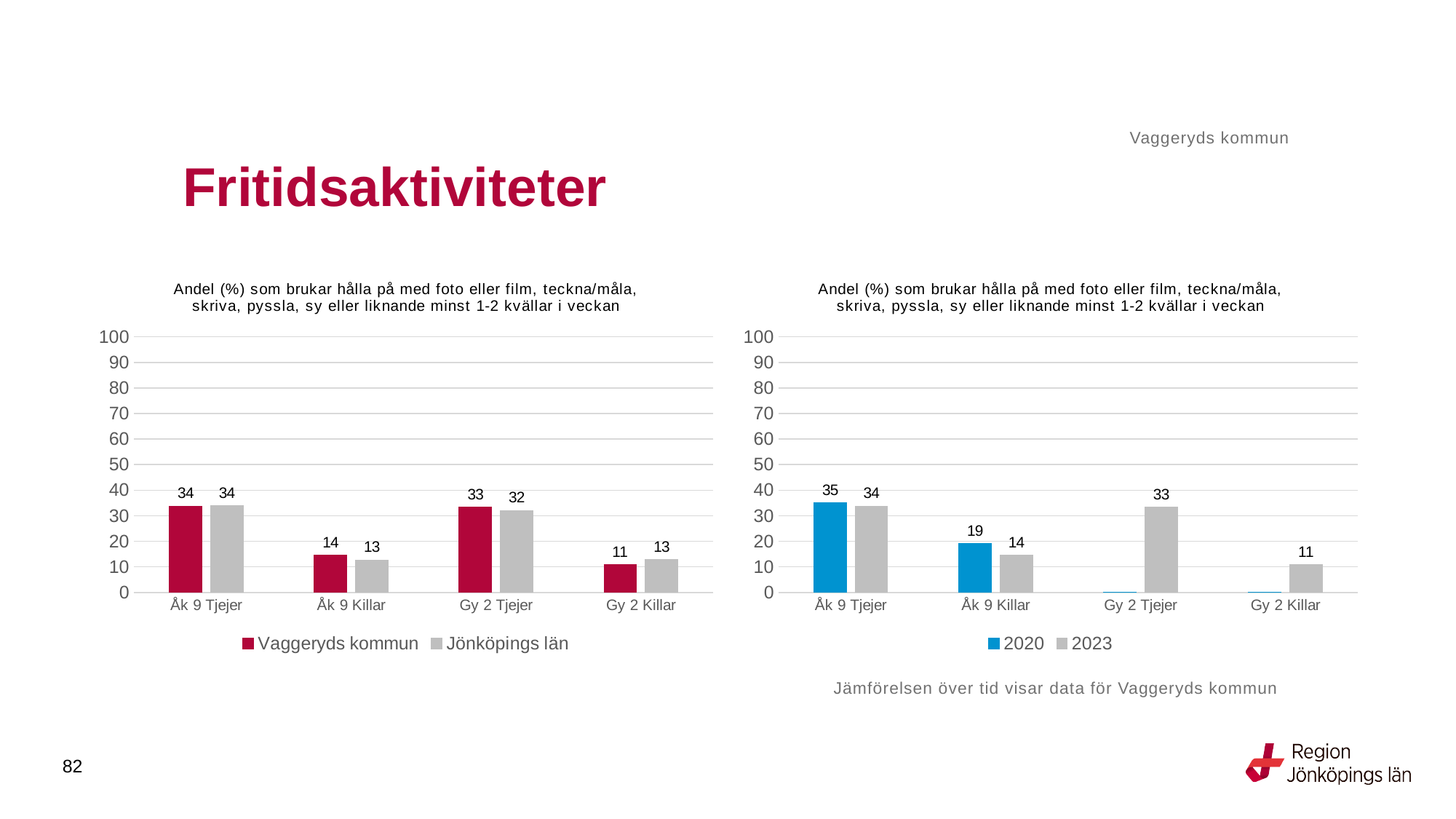
In the left chart, how many series does the legend list? 2 In the left chart, what is the difference between Vaggeryds kommun and Jönköpings län for Gy 2 Killar? 2 In the right chart, what is the difference between 2020 and 2023 for Åk 9 Killar? 5 In the left chart, what is the value for Jönköpings län for Gy 2 Killar? 13 In the left chart, what is the value for Vaggeryds kommun for Åk 9 Tjejer? 34 In the right chart, what is the value for 2023 for Gy 2 Tjejer? 33 In the left chart, how many categories are shown on the x axis? 4 In the left chart, which category has the lowest value for Vaggeryds kommun? Gy 2 Killar In the right chart, what is the value for 2020 for Åk 9 Killar? 19 In the right chart, which category has the highest value for 2023? Åk 9 Tjejer In the right chart, which is larger for Åk 9 Tjejer: the 2020 value or the 2023 value? 2020 What type of chart is the right chart? Bar chart